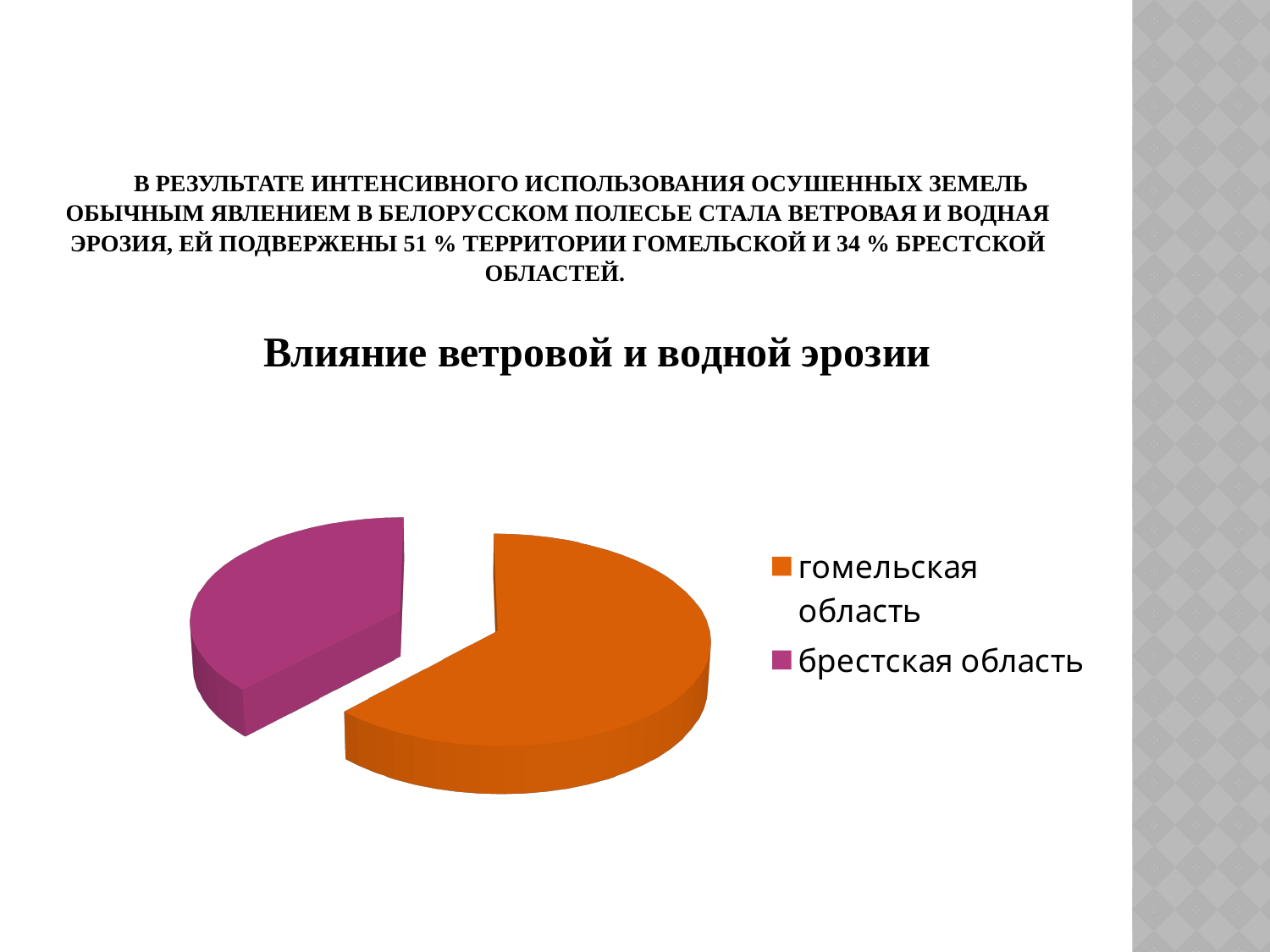
What colour is the slice for гомельская область? orange Is the slice for брестская область more or less than half of the pie? less What is the title of the chart? Влияние ветровой и водной эрозии Is the slice for гомельская область more or less than half of the pie? more Which category has the smallest slice of the pie? брестская область What kind of chart is shown on the slide? pie chart How many slices does the pie chart have? 2 Which slice is larger, гомельская область or брестская область? гомельская область Which category has the largest slice of the pie? гомельская область How many entries does the legend list? 2